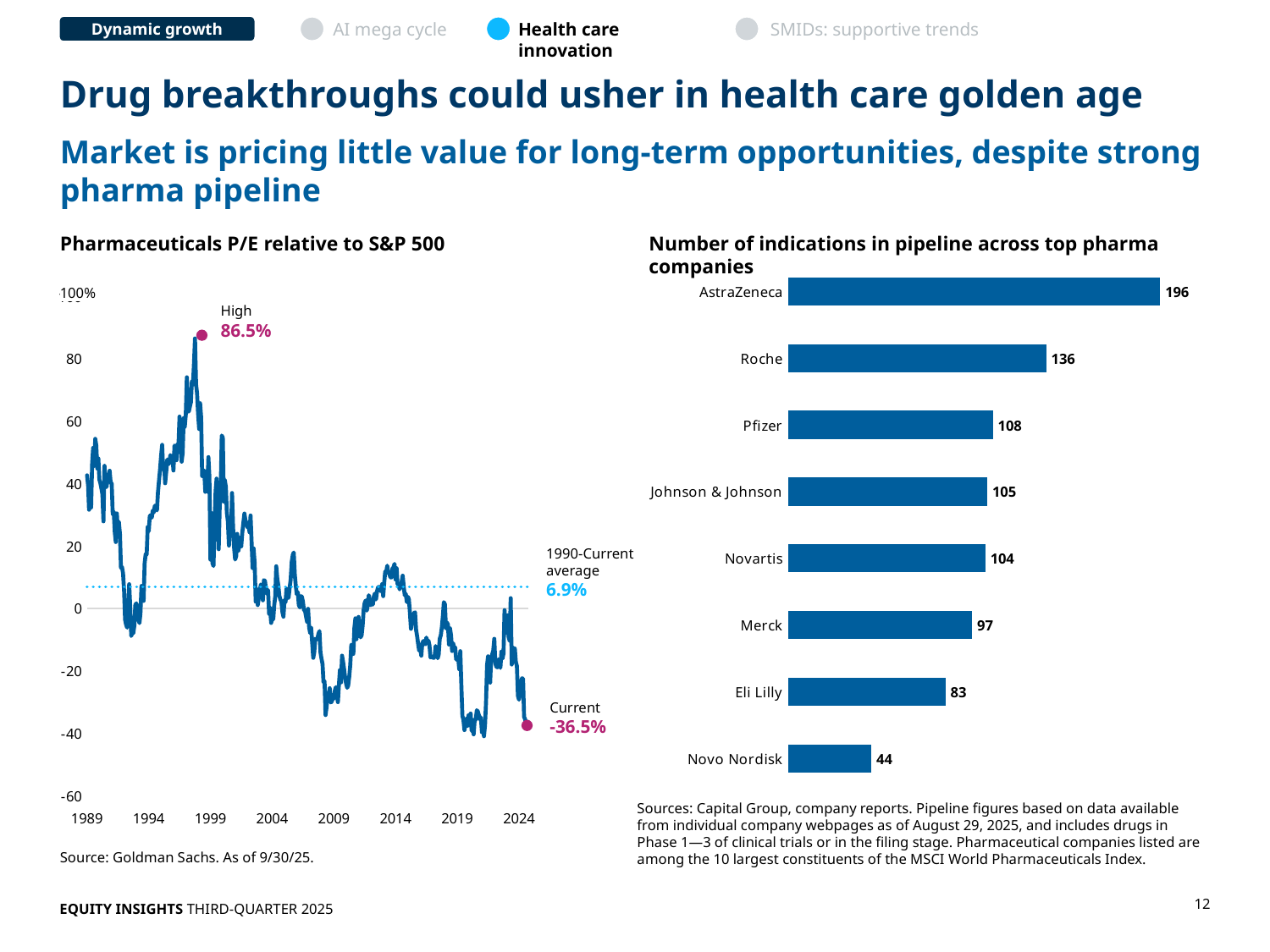
What type of chart is 'Pharmaceuticals P/E relative to S&P 500'? Line chart In the 'Number of indications in pipeline across top pharma companies' chart, what is the difference between Roche and Pfizer? 28 In the 'Pharmaceuticals P/E relative to S&P 500' chart, what is the high value marked on the line? 86.5% How many companies are shown in the 'Number of indications in pipeline across top pharma companies' chart? 8 In the 'Number of indications in pipeline across top pharma companies' chart, what is the value for Novo Nordisk? 44 In the 'Number of indications in pipeline across top pharma companies' chart, how many indications does AstraZeneca have in its pipeline? 196 In the 'Number of indications in pipeline across top pharma companies' chart, which company has the highest number of indications? AstraZeneca What type of chart is 'Number of indications in pipeline across top pharma companies'? Bar chart In the 'Pharmaceuticals P/E relative to S&P 500' chart, what is the 1990-Current average? 6.9% In the 'Number of indications in pipeline across top pharma companies' chart, which company has the lowest number of indications? Novo Nordisk In the 'Number of indications in pipeline across top pharma companies' chart, which has more indications, Merck or Eli Lilly? Merck In the 'Pharmaceuticals P/E relative to S&P 500' chart, what is the current value? -36.5%